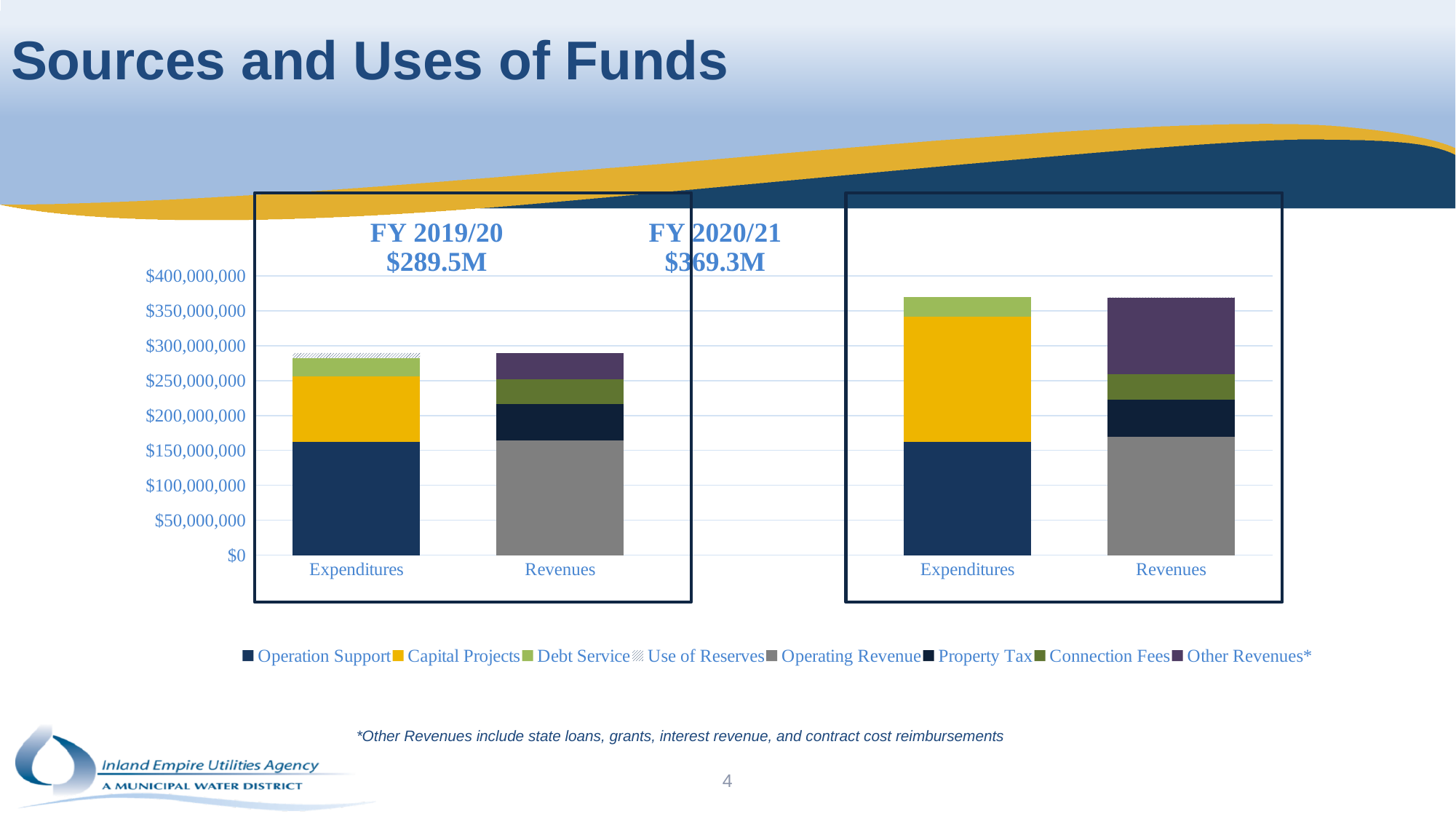
Which fiscal year has the larger labelled total, FY 2019/20 or FY 2020/21? FY 2020/21 Do the labelled totals rise or fall from FY 2019/20 to FY 2020/21? rise What is the difference between the FY 2020/21 total ($369.3M) and the FY 2019/20 total ($289.5M)? $79.8M Is the FY 2020/21 Expenditures bar greater or less than $350,000,000? greater What kind of chart is shown on the slide? Stacked bar chart Is the FY 2020/21 Revenues bar greater or less than $350,000,000? greater Is the FY 2019/20 Expenditures bar greater or less than $300,000,000? less How many series does the chart legend list? 8 How many bars are plotted across the two fiscal-year panels? 4 What total amount is labelled for FY 2019/20? $289.5M What is the title of the slide containing the chart? Sources and Uses of Funds What total amount is labelled for FY 2020/21? $369.3M